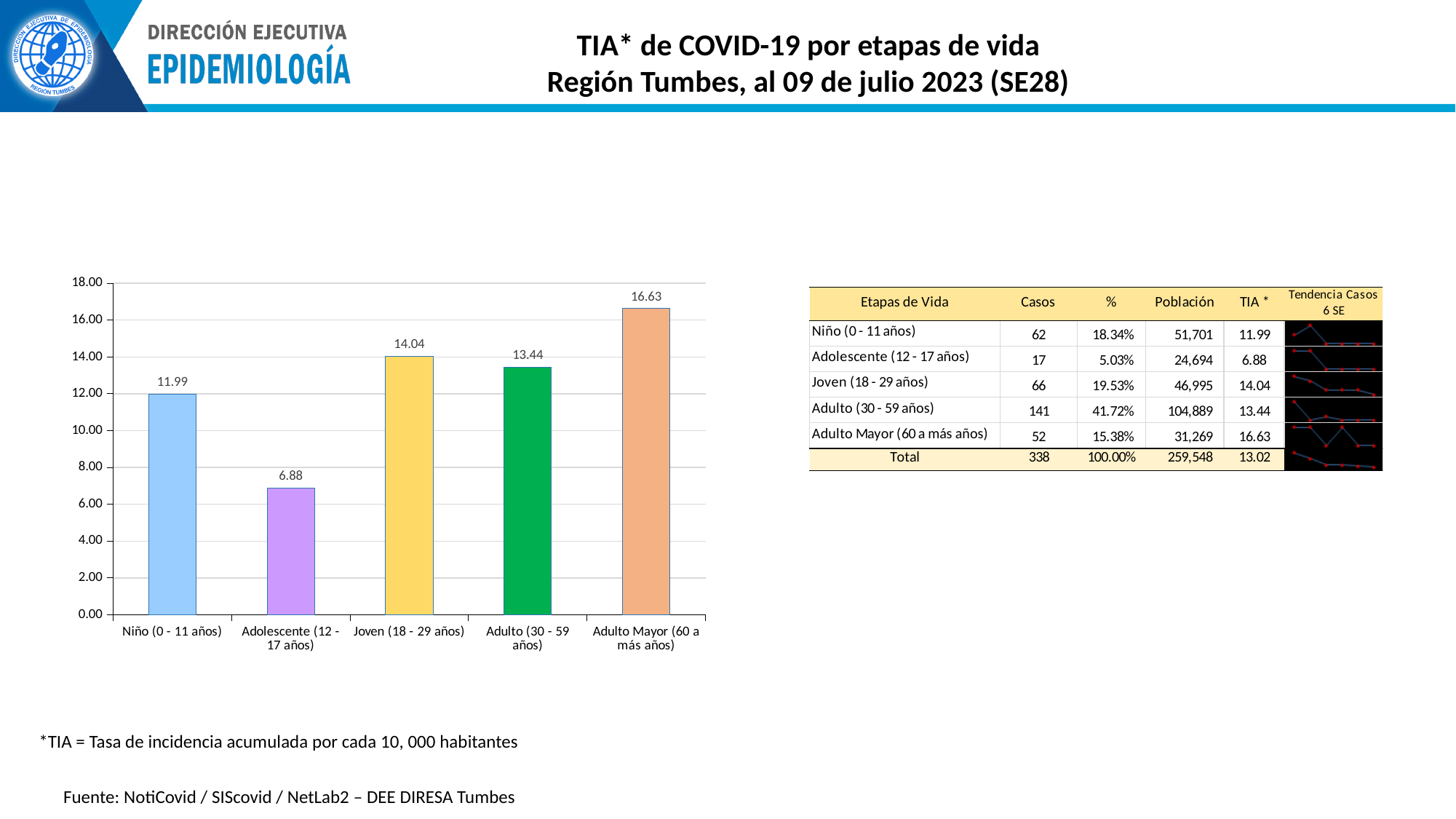
Which life stage has the lowest TIA in the bar chart? Adolescente (12 - 17 años) Which life stage has the highest TIA in the bar chart? Adulto Mayor (60 a más años) What is the TIA value for Niño (0 - 11 años)? 11.99 Is the TIA value for Niño (0 - 11 años) greater or less than 10.00? greater What is the TIA value for Adolescente (12 - 17 años)? 6.88 How many life-stage categories are shown in the bar chart? 5 What is the difference between the TIA for Adulto Mayor (60 a más años) and Adolescente (12 - 17 años)? 9.75 What kind of chart is shown on the slide? bar chart What is the difference between the TIA for Joven (18 - 29 años) and Adulto (30 - 59 años)? 0.60 What colour is the bar for Adulto (30 - 59 años)? green Which has a higher TIA, Joven (18 - 29 años) or Adulto (30 - 59 años)? Joven (18 - 29 años) What is the TIA value for Adulto Mayor (60 a más años)? 16.63